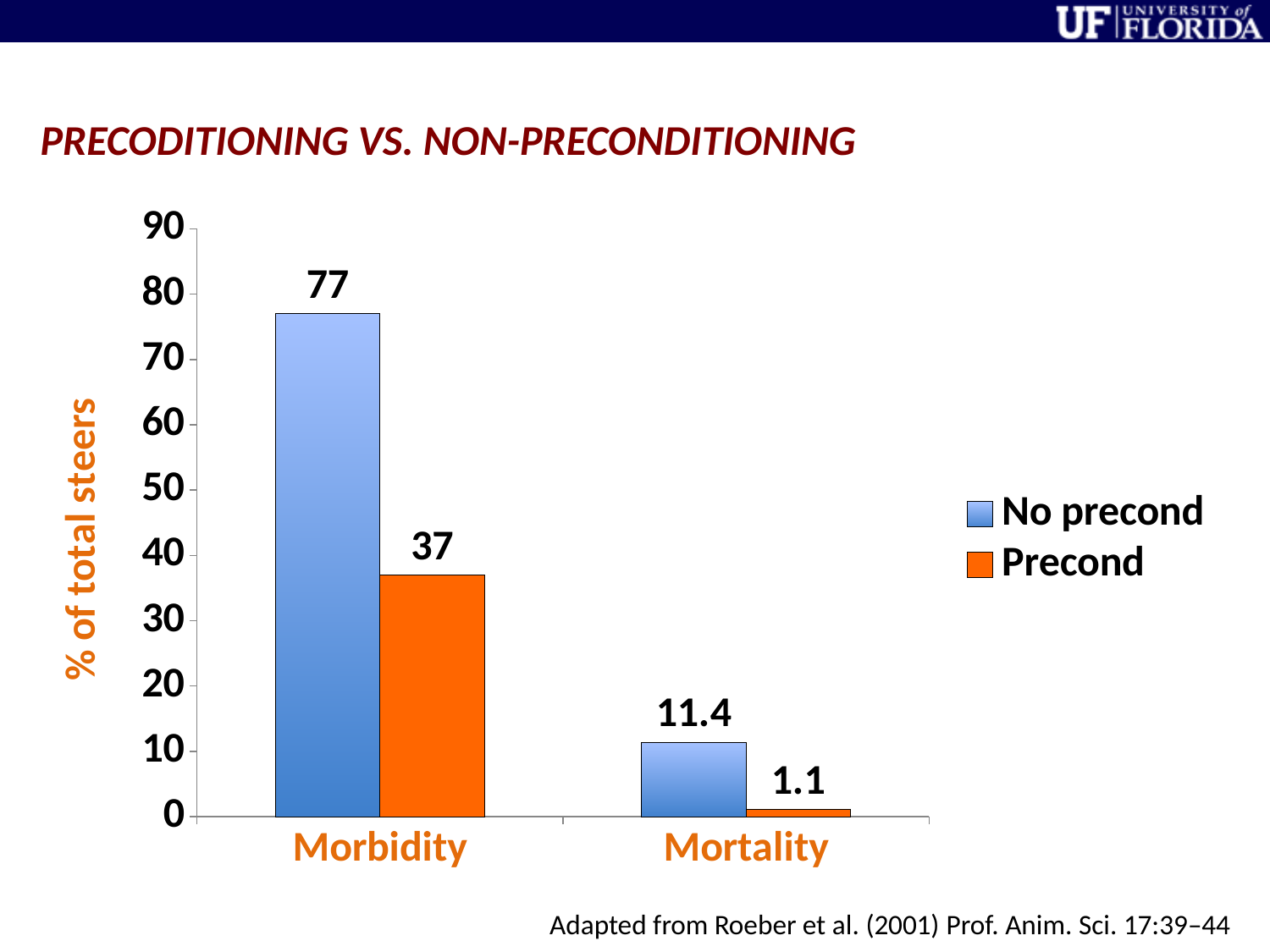
Which category has the lowest value for the Precond series? Mortality What is the value for Precond in the Mortality category? 1.1 What is the difference between No precond and Precond in the Morbidity category? 40 Which category has the highest value for the No precond series? Morbidity Which is larger in the Mortality category, No precond or Precond? No precond What is the value for No precond in the Mortality category? 11.4 What is the difference between No precond and Precond in the Mortality category? 10.3 What is the value for No precond in the Morbidity category? 77 What is the value for Precond in the Morbidity category? 37 How many categories are shown on the x axis? 2 What kind of chart is shown on the slide? Bar chart How many series does the legend list? 2